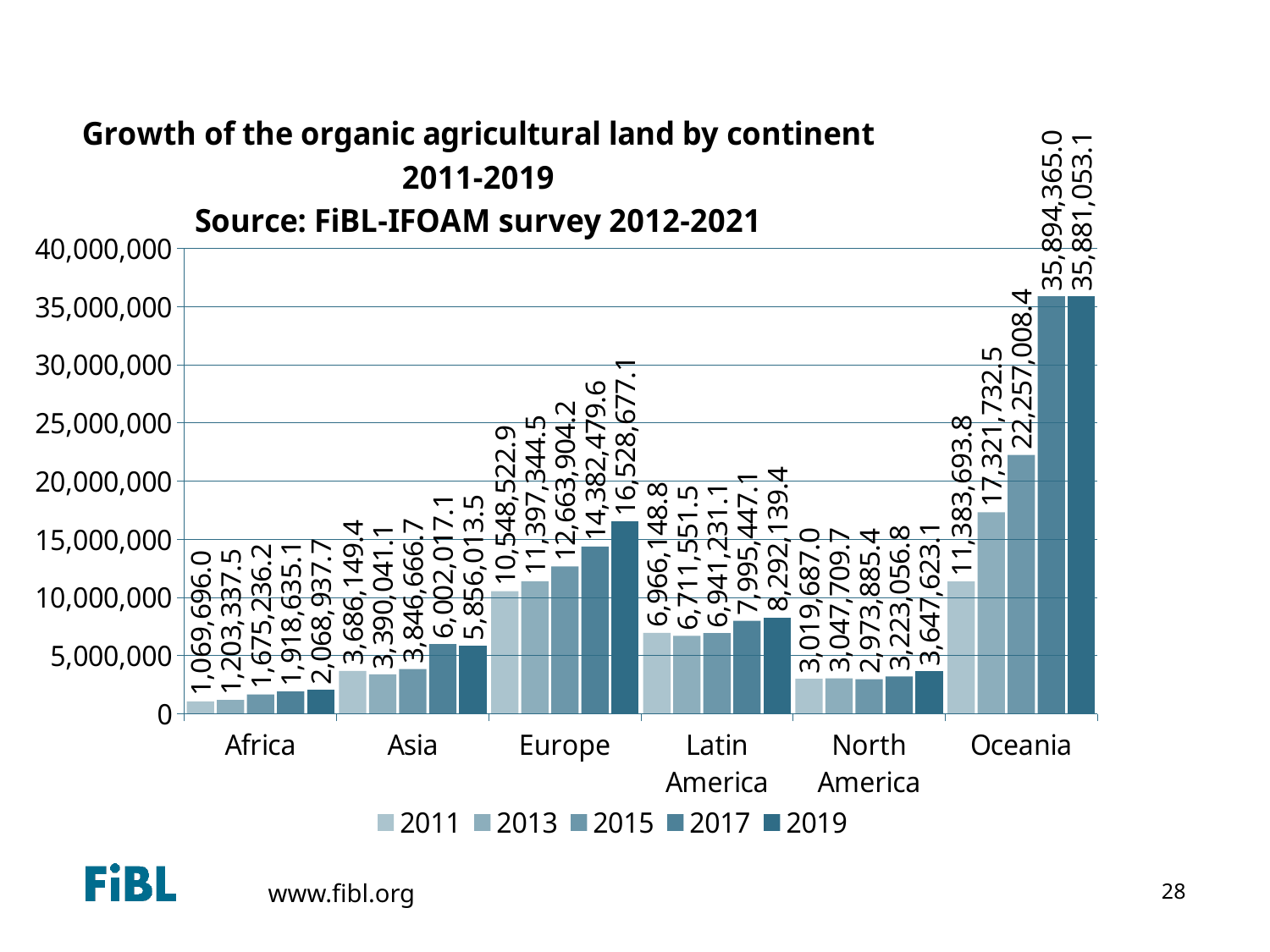
Do the values for Africa rise or fall from 2011 to 2019? rise What is the value for Oceania in 2017? 35,894,365.0 Which continent has the highest value in 2019? Oceania What is the value for Africa in 2011? 1,069,696.0 How many series does the legend list? 5 What is the difference between the 2019 and 2011 values for Europe? 5,980,154.2 Which continent has the lowest value in 2011? Africa Is the 2015 value for Oceania greater or less than 20,000,000? greater What is the value for Europe in 2019? 16,528,677.1 Which is larger, the 2019 value for Asia or the 2019 value for Latin America? Latin America How many continents are shown on the x axis? 6 What kind of chart is this? bar chart